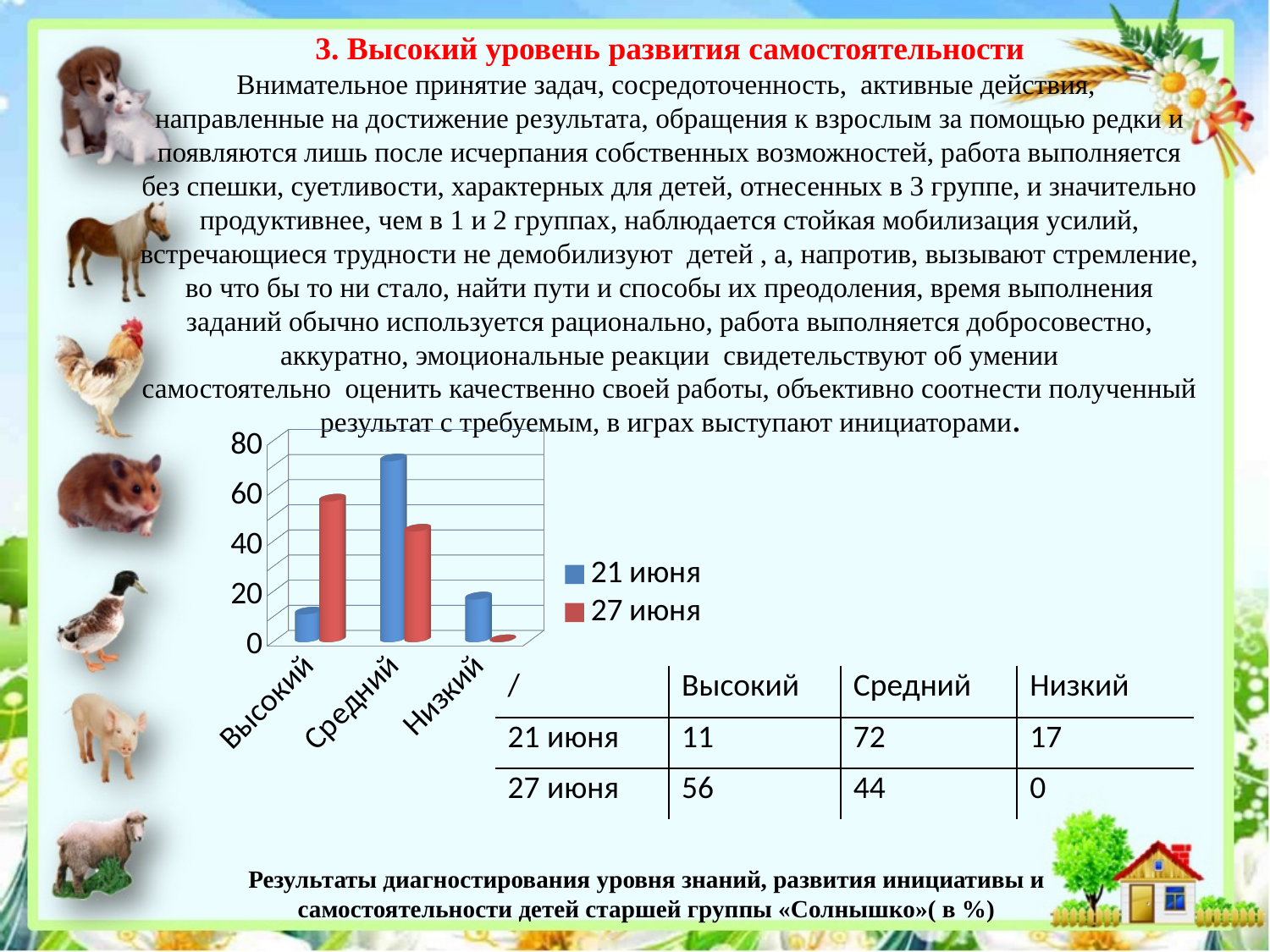
What kind of chart is shown on the slide? bar chart How many series does the chart legend list? 2 Which category has the highest value in the 21 июня series? Средний Which is larger for Средний: the 21 июня value or the 27 июня value? 21 июня What is the value for Низкий in the 27 июня series? 0 Which series is shown in red in the chart? 27 июня Is the value for Средний in the 21 июня series greater or less than 60? greater What is the difference between the 27 июня and 21 июня values for Высокий? 45 Which category has the lowest value in the 27 июня series? Низкий What is the value for Высокий in the 27 июня series? 56 How many categories are shown on the x axis of the chart? 3 What is the value for Средний in the 21 июня series? 72